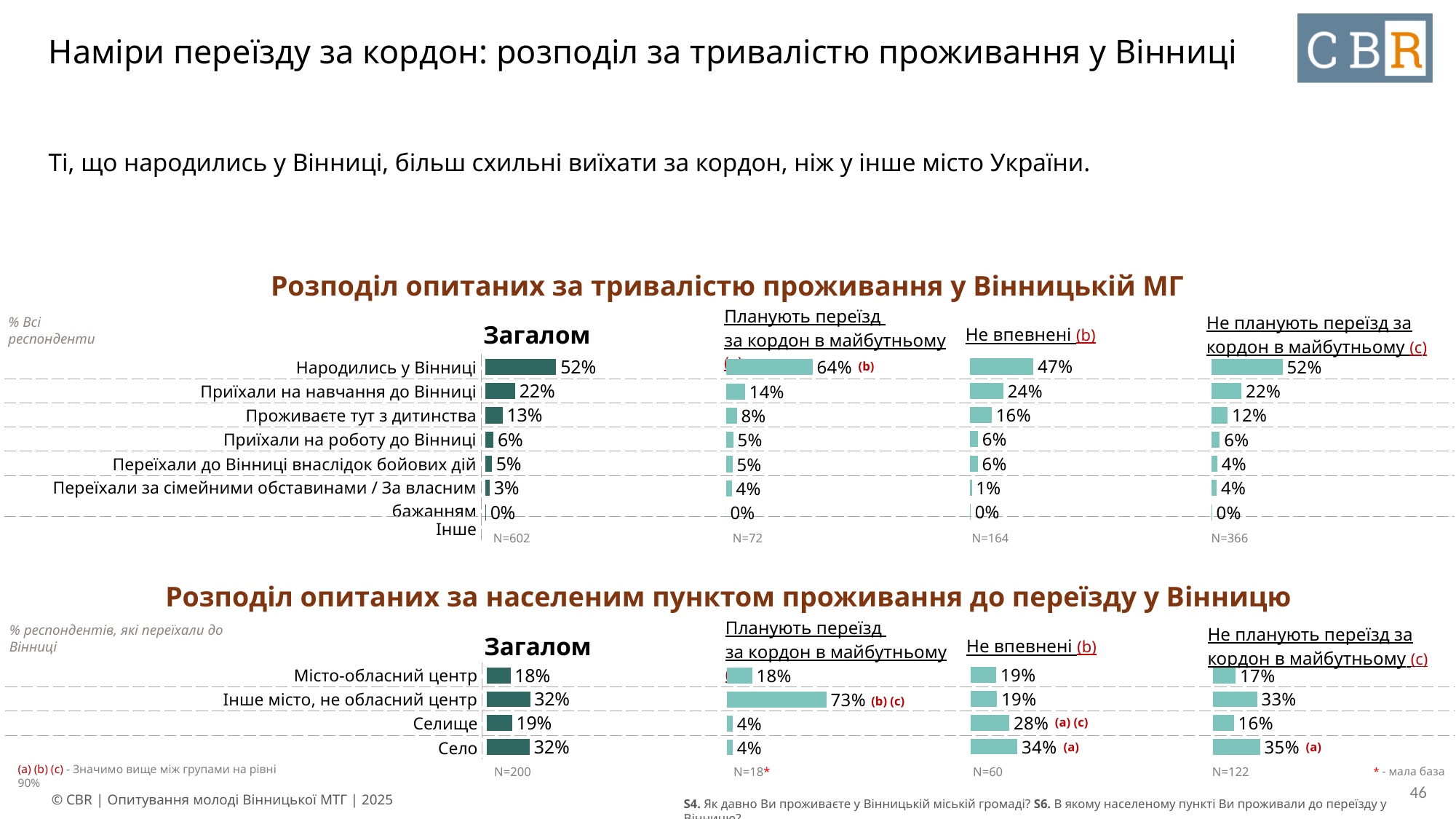
In the top chart, what is the sample size (N) for the 'Загалом' column? N=602 In the top chart (Розподіл опитаних за тривалістю проживання у Вінницькій МГ), what is the value for 'Народились у Вінниці' in the 'Загалом' column? 52% In the top chart, what is the value for 'Приїхали на навчання до Вінниці' in the 'Не впевнені' column? 24% In the bottom chart (Розподіл опитаних за населеним пунктом проживання до переїзду у Вінницю), what is the value for 'Інше місто, не обласний центр' in the 'Планують переїзд за кордон в майбутньому' column? 73% In the bottom chart, what is the difference between 'Село' and 'Місто-обласний центр' in the 'Загалом' column? 14% In the top chart, what is the difference between 'Народились у Вінниці' in the 'Планують переїзд за кордон в майбутньому' column and in the 'Не впевнені' column? 17% What type of chart is used on this slide? Bar chart In the bottom chart, which category has the lowest value in the 'Планують переїзд за кордон в майбутньому' column? Селище and Село (both 4%) In the top chart, which category has the highest value in the 'Не планують переїзд за кордон в майбутньому' column? Народились у Вінниці In the top chart, what is the value for 'Народились у Вінниці' in the 'Планують переїзд за кордон в майбутньому' column? 64% In the bottom chart, how many categories are shown? 4 In the bottom chart, which is larger in the 'Не впевнені' column: 'Селище' or 'Село'? Село